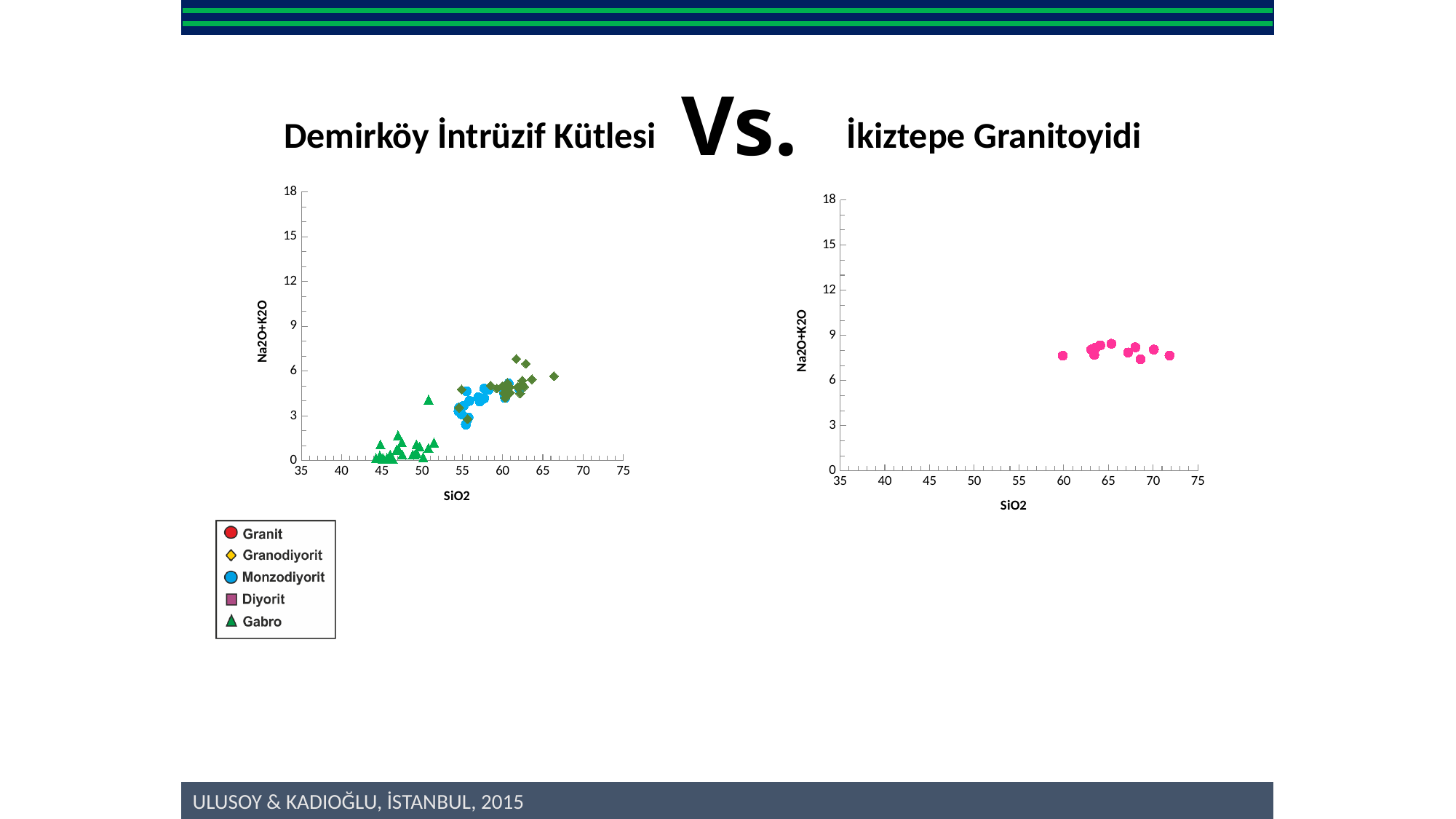
In the Demirköy İntrüzif Kütlesi chart, which group has higher Na2O+K2O values, Gabro or Granodiyorit? Granodiyorit What kind of chart is the Demirköy İntrüzif Kütlesi chart on the left? scatter chart In the Demirköy İntrüzif Kütlesi chart, what is the label of the x axis? SiO2 In the Demirköy İntrüzif Kütlesi chart, are the Na2O+K2O values of the Gabro points greater or less than 6? less In the İkiztepe Granitoyidi chart, are the Na2O+K2O values of the plotted points greater or less than 6? greater In the Demirköy İntrüzif Kütlesi chart, which group has the lowest Na2O+K2O values? Gabro In the Demirköy İntrüzif Kütlesi chart, do the Na2O+K2O values rise or fall as SiO2 increases? rise How many entries does the legend below the Demirköy İntrüzif Kütlesi chart list? 5 What kind of chart is the İkiztepe Granitoyidi chart on the right? scatter chart What is the highest value shown on the y axis of the İkiztepe Granitoyidi chart? 18 In the İkiztepe Granitoyidi chart, what is the label of the y axis? Na2O+K2O In the İkiztepe Granitoyidi chart, are the SiO2 values of the plotted points greater or less than 55? greater